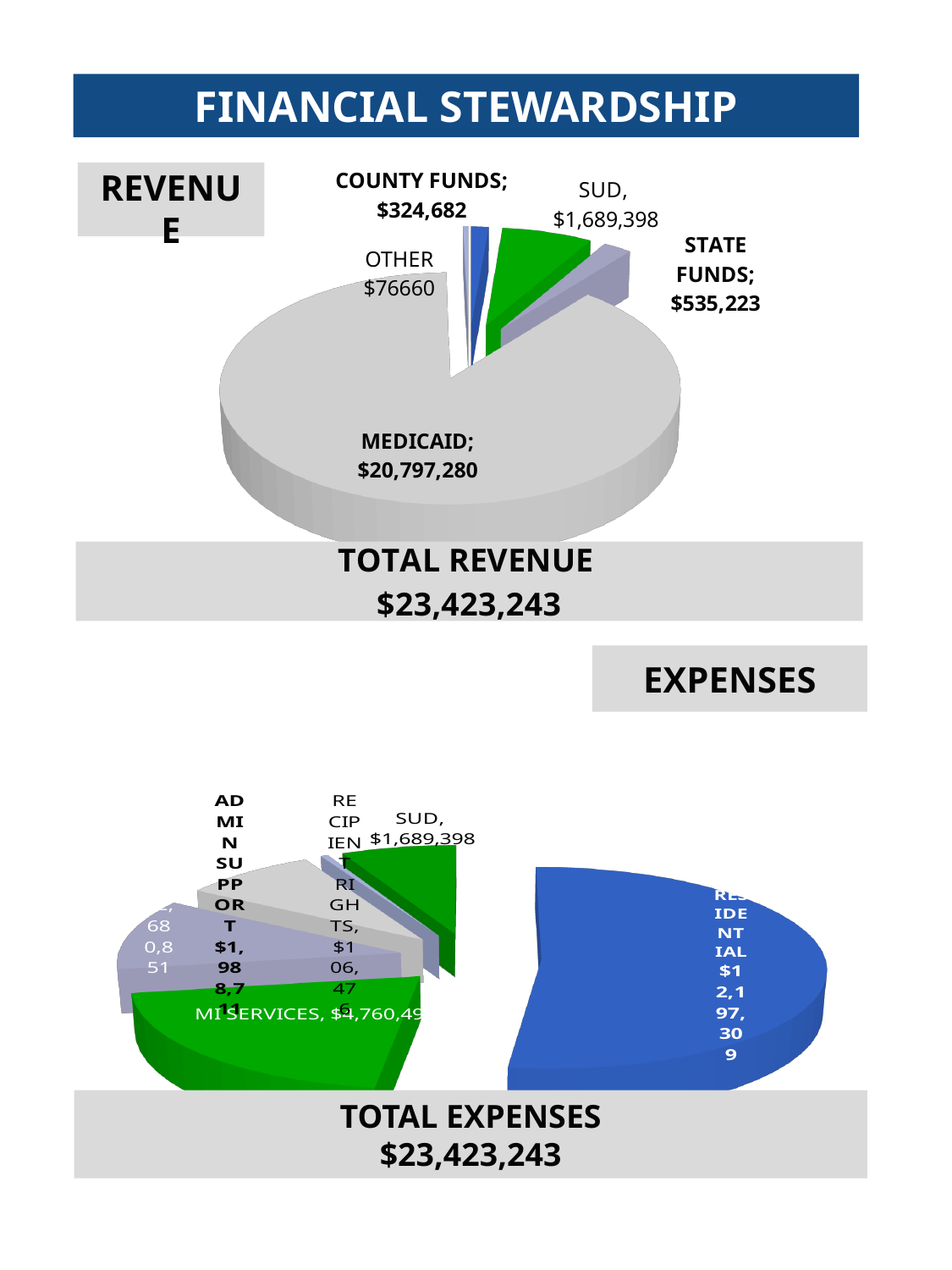
In the Revenue pie chart, which category has the largest slice? Medicaid In the Revenue pie chart, what is the value for Medicaid? $20,797,280 In the Revenue pie chart, what is the value for SUD? $1,689,398 In the Revenue pie chart, how much larger is State Funds than County Funds? $210,541 In the Revenue pie chart, what is the value for State Funds? $535,223 What kind of chart is used for the Revenue data? Pie chart How many categories are shown in the Revenue pie chart? 5 In the Revenue pie chart, what is the value for County Funds? $324,682 In the Revenue pie chart, which category has the smallest slice? Other In the Revenue pie chart, what is the value for Other? $76660 In the Expenses pie chart, what is the value for SUD? $1,689,398 In the Revenue pie chart, which is larger: SUD or State Funds? SUD